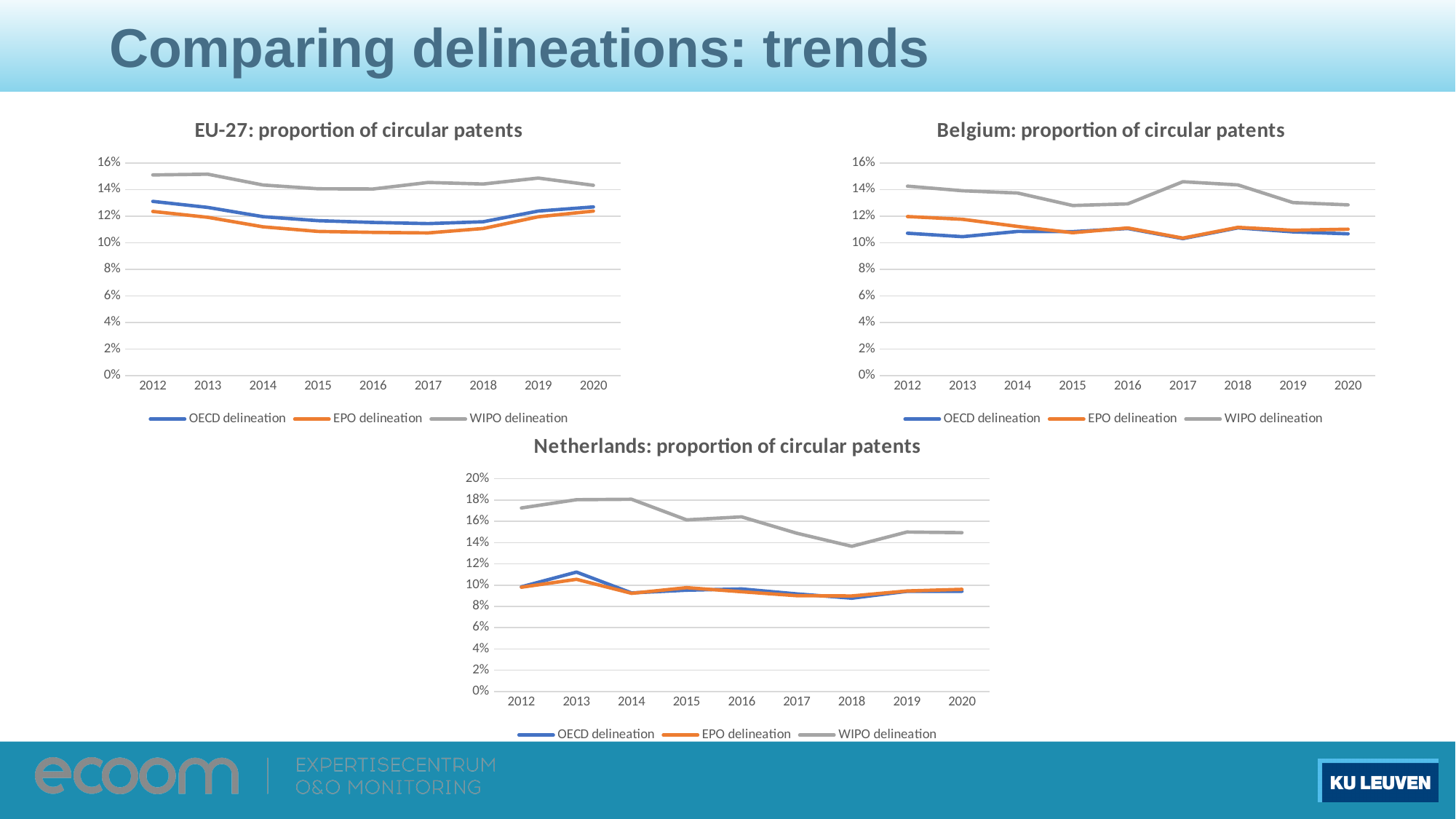
In the 'Netherlands: proportion of circular patents' chart, is the WIPO delineation value for 2013 greater or less than 16%? greater In the 'EU-27: proportion of circular patents' chart, is the OECD delineation value for 2012 greater or less than 12%? greater In the 'Netherlands: proportion of circular patents' chart, does the WIPO delineation line rise or fall from 2014 to 2018? fall In the 'EU-27: proportion of circular patents' chart, which series has the highest values across all years? WIPO delineation In the 'Belgium: proportion of circular patents' chart, which series has the lowest value in 2013? OECD delineation How many series does the legend of the 'Belgium: proportion of circular patents' chart list? 3 In the 'Belgium: proportion of circular patents' chart, is the WIPO delineation value for 2017 greater or less than 14%? greater In the 'Netherlands: proportion of circular patents' chart, which series has the highest values across all years? WIPO delineation How many years are shown on the x axis of the 'Netherlands: proportion of circular patents' chart? 9 What kind of chart is the 'EU-27: proportion of circular patents' chart? line chart What is the highest value shown on the y axis of the 'Netherlands: proportion of circular patents' chart? 20%